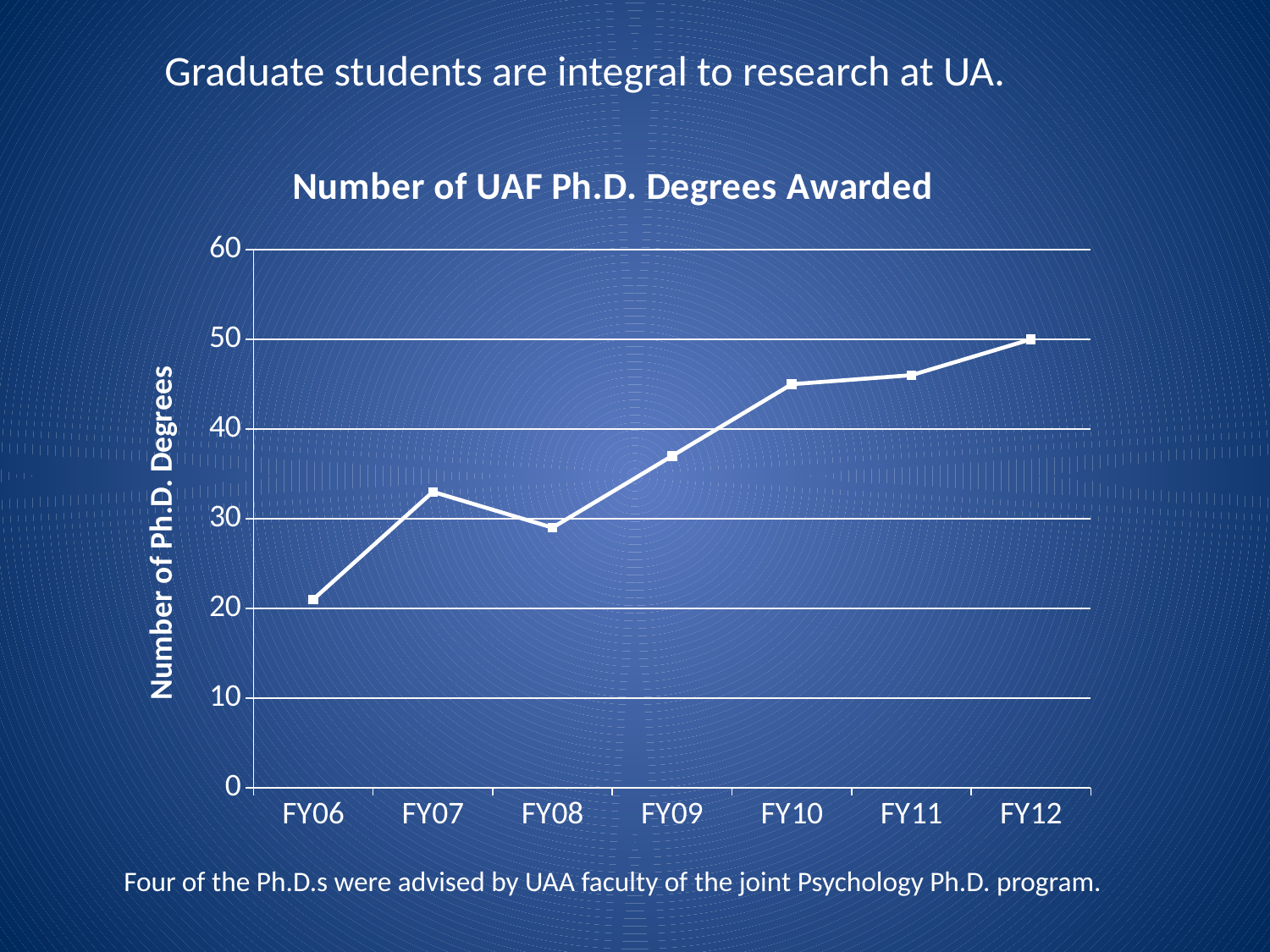
Do the values generally rise or fall from FY06 to FY12? rise How many fiscal years are plotted on the x axis? 7 What is the title of the chart? Number of UAF Ph.D. Degrees Awarded What is the number of Ph.D. degrees awarded in FY12? 50 What kind of chart is shown on the slide? line chart Is the value for FY10 greater or less than 40? greater Is the value for FY06 greater or less than 30? less Which is larger, the value for FY07 or the value for FY08? FY07 Is the value for FY09 greater or less than 40? less Which fiscal year has the lowest number of Ph.D. degrees awarded? FY06 Which fiscal year has the highest number of Ph.D. degrees awarded? FY12